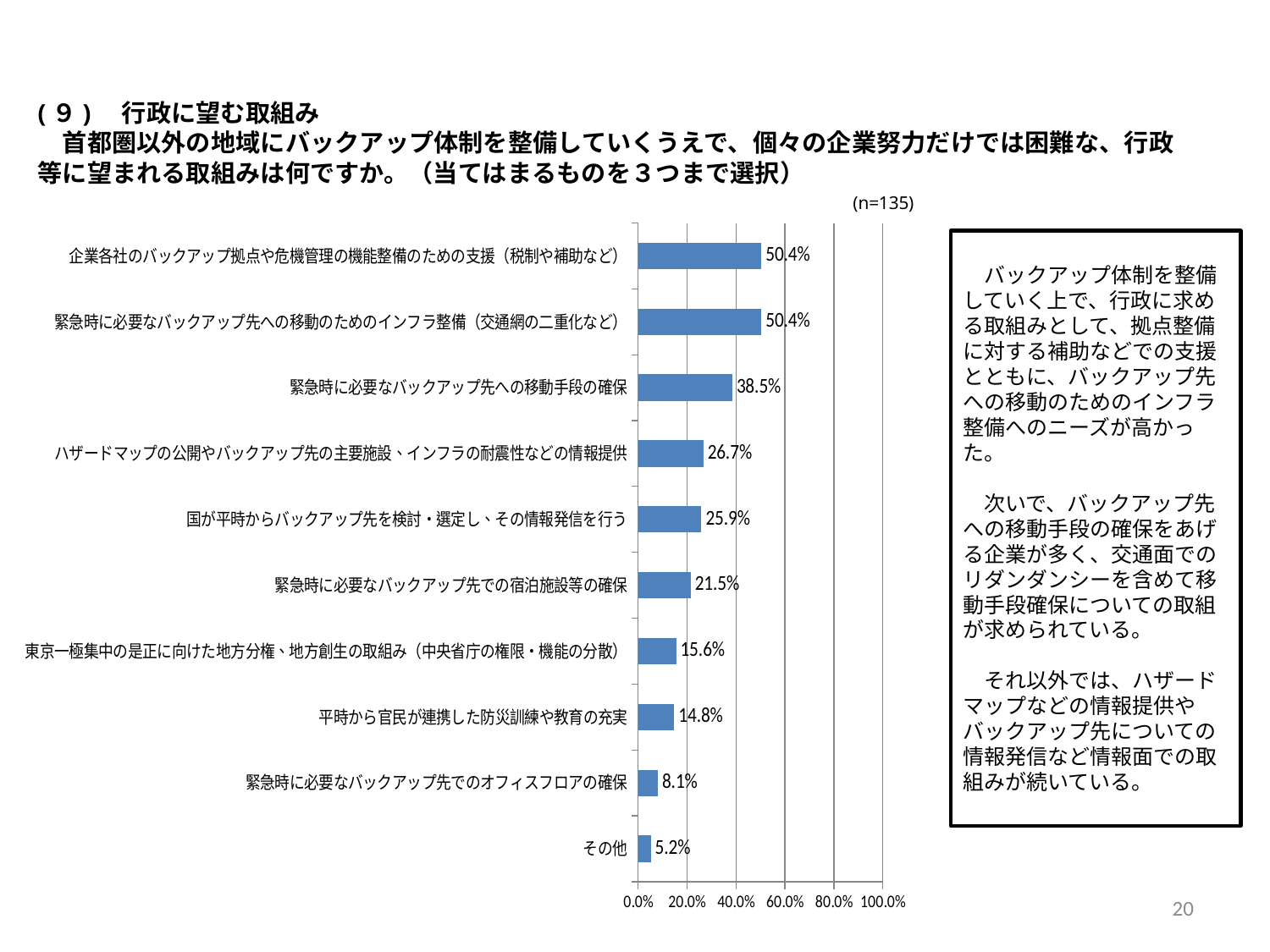
Which is larger, the value for 東京一極集中の是正に向けた地方分権、地方創生の取組み or the value for 緊急時に必要なバックアップ先でのオフィスフロアの確保? 東京一極集中の是正に向けた地方分権、地方創生の取組み What is the value for 緊急時に必要なバックアップ先でのオフィスフロアの確保? 8.1% What is the difference between the values for 緊急時に必要なバックアップ先への移動手段の確保 and 緊急時に必要なバックアップ先での宿泊施設等の確保? 17.0% Is the value for 国が平時からバックアップ先を検討・選定し、その情報発信を行う greater or less than 40.0%? less How many categories are plotted in the bar chart? 10 What sample size (n) is shown above the chart? n=135 What is the value for 平時から官民が連携した防災訓練や教育の充実? 14.8% What is the highest value shown in the chart? 50.4% What is the value for ハザードマップの公開やバックアップ先の主要施設、インフラの耐震性などの情報提供? 26.7% What type of chart is shown on the slide? bar chart Which category has the lowest value? その他 What is the value for 緊急時に必要なバックアップ先への移動手段の確保? 38.5%